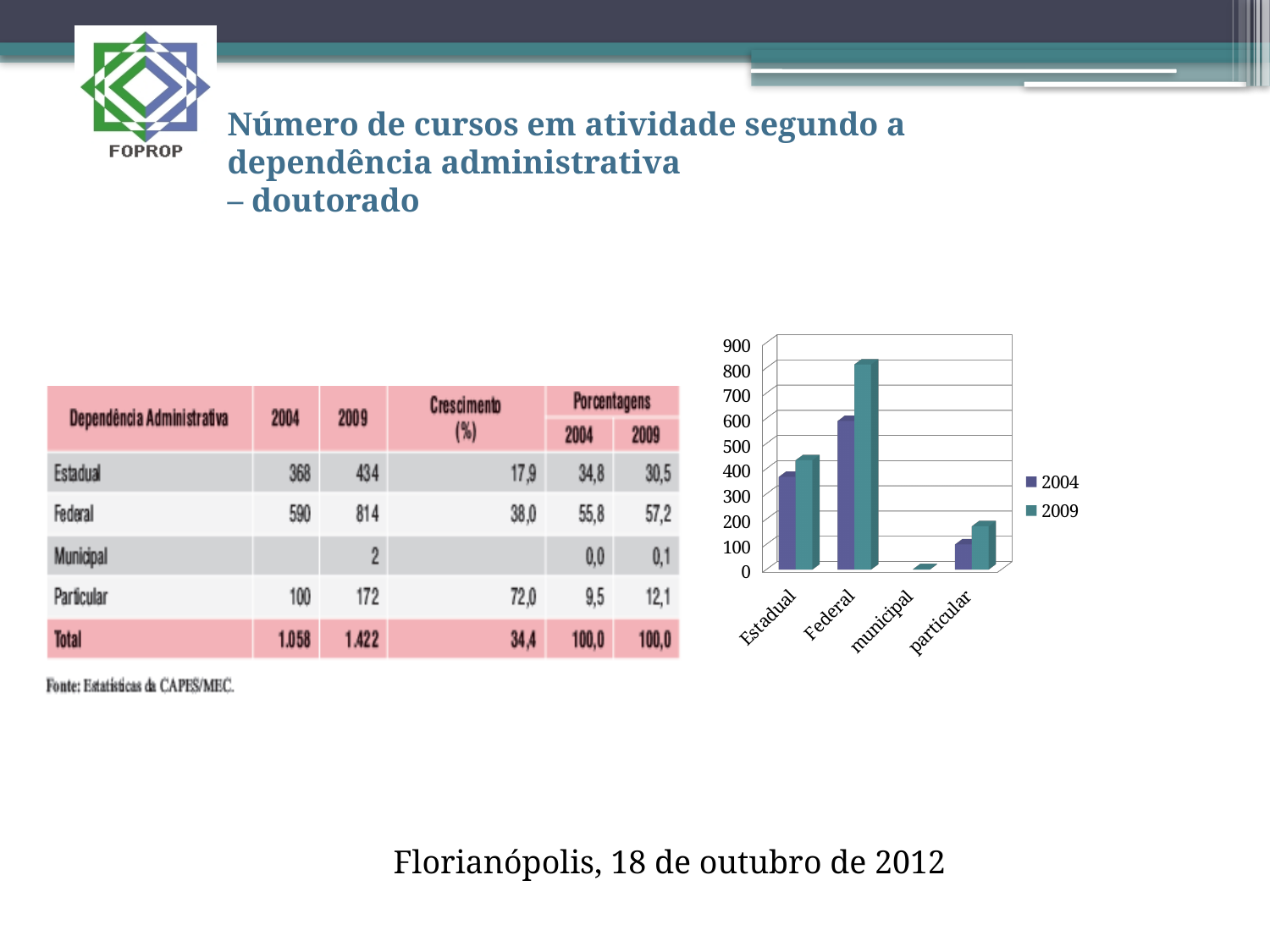
According to the table on the slide, what is the 2009 value for Federal plotted in the chart? 814 Which category has the tallest bar in the chart? Federal Is the 2004 value for Estadual in the chart greater or less than 400? less Which category has the lowest bars in the chart? municipal How many categories are shown on the x axis of the chart? 4 In the chart, is the 2009 bar for Federal taller than the 2009 bar for Estadual? yes Is the 2009 value for Federal in the chart greater or less than 700? greater For Estadual, which series has the taller bar in the chart, 2004 or 2009? 2009 Is the 2009 value for particular in the chart greater or less than 200? less What kind of chart is shown on the right of the slide? bar chart What are the two entries in the chart's legend? 2004 and 2009 How many series does the chart's legend list? 2